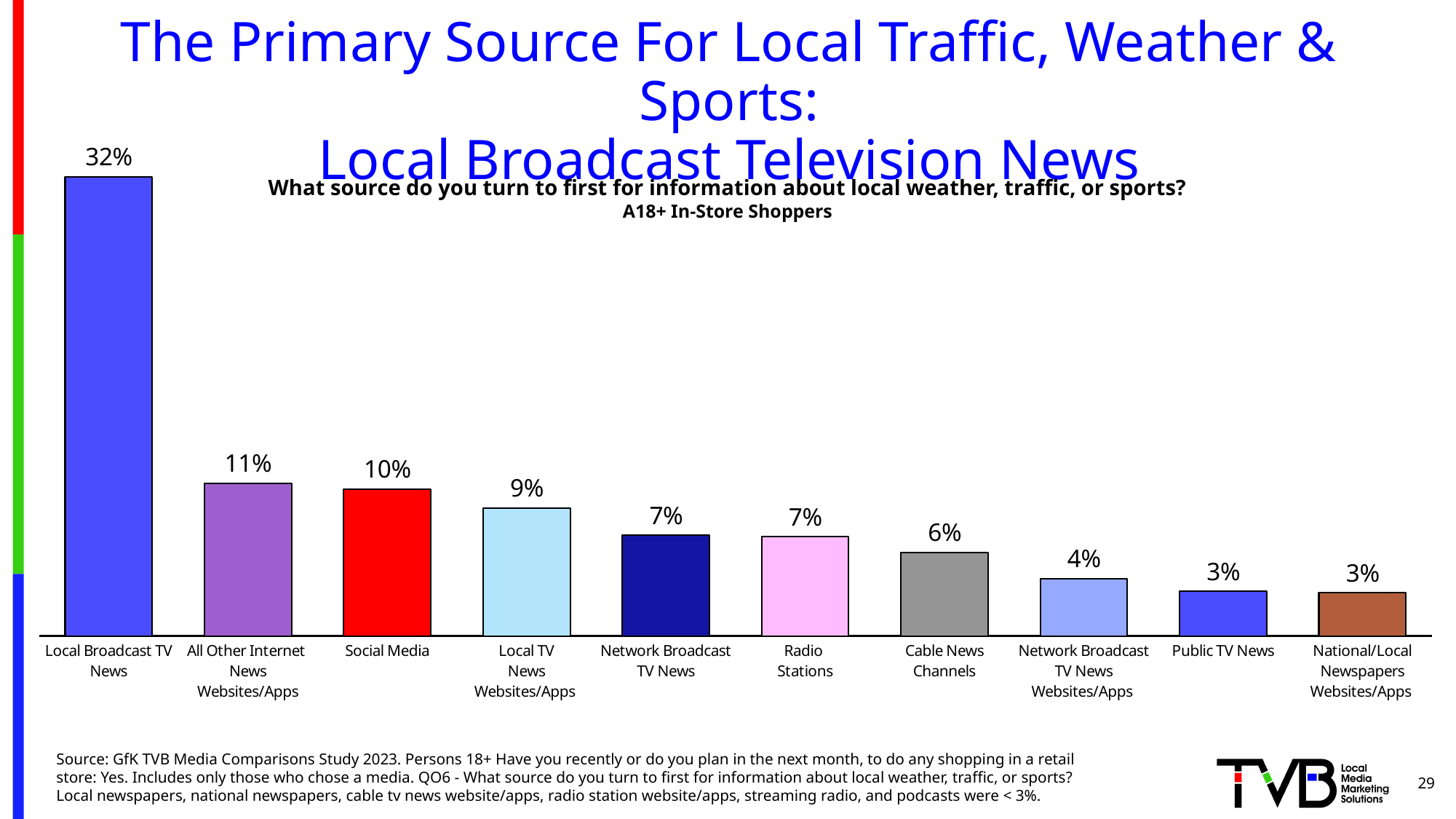
Which is larger, the value for Social Media or the value for Cable News Channels? Social Media What percentage of A18+ in-store shoppers turn first to Local Broadcast TV News for local weather, traffic, or sports? 32% Do the values rise or fall moving from left to right across the chart? Fall What is the difference between the values for Local TV News Websites/Apps and Radio Stations? 2% What kind of chart is shown on the slide? Bar chart What is the difference between the values for Local Broadcast TV News and All Other Internet News Websites/Apps? 21% What is the value shown for Social Media? 10% Which two sources both have a value of 7%? Network Broadcast TV News and Radio Stations What is the value shown for Network Broadcast TV News Websites/Apps? 4% Which source has the highest value in the chart? Local Broadcast TV News How many sources (bars) are shown in the chart? 10 What is the value shown for Cable News Channels? 6%